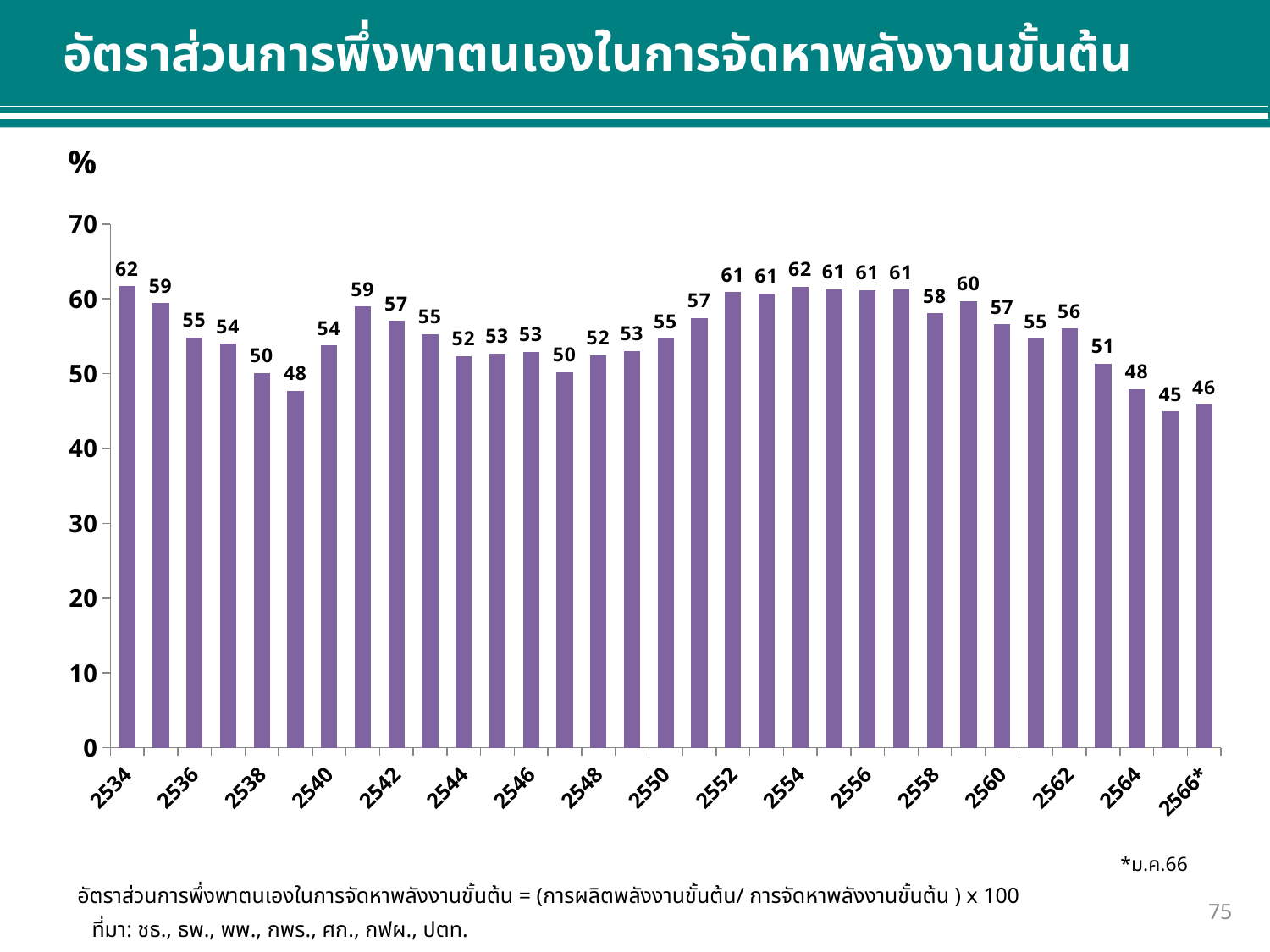
What is the value for 2538? 50 What is the difference between the values for 2534 and 2566*? 16 What kind of chart is shown on the slide? bar chart Do the values rise or fall from 2560 to 2566*? fall What is the value for 2560? 57 Which is larger, the value for 2554 or the value for 2564? 2554 What unit is shown at the top of the y axis? % What is the value for 2566*? 46 What is the value for 2552? 61 How many bars are plotted on the chart? 33 What is the value for 2534? 62 What is the lowest value shown on the chart? 45